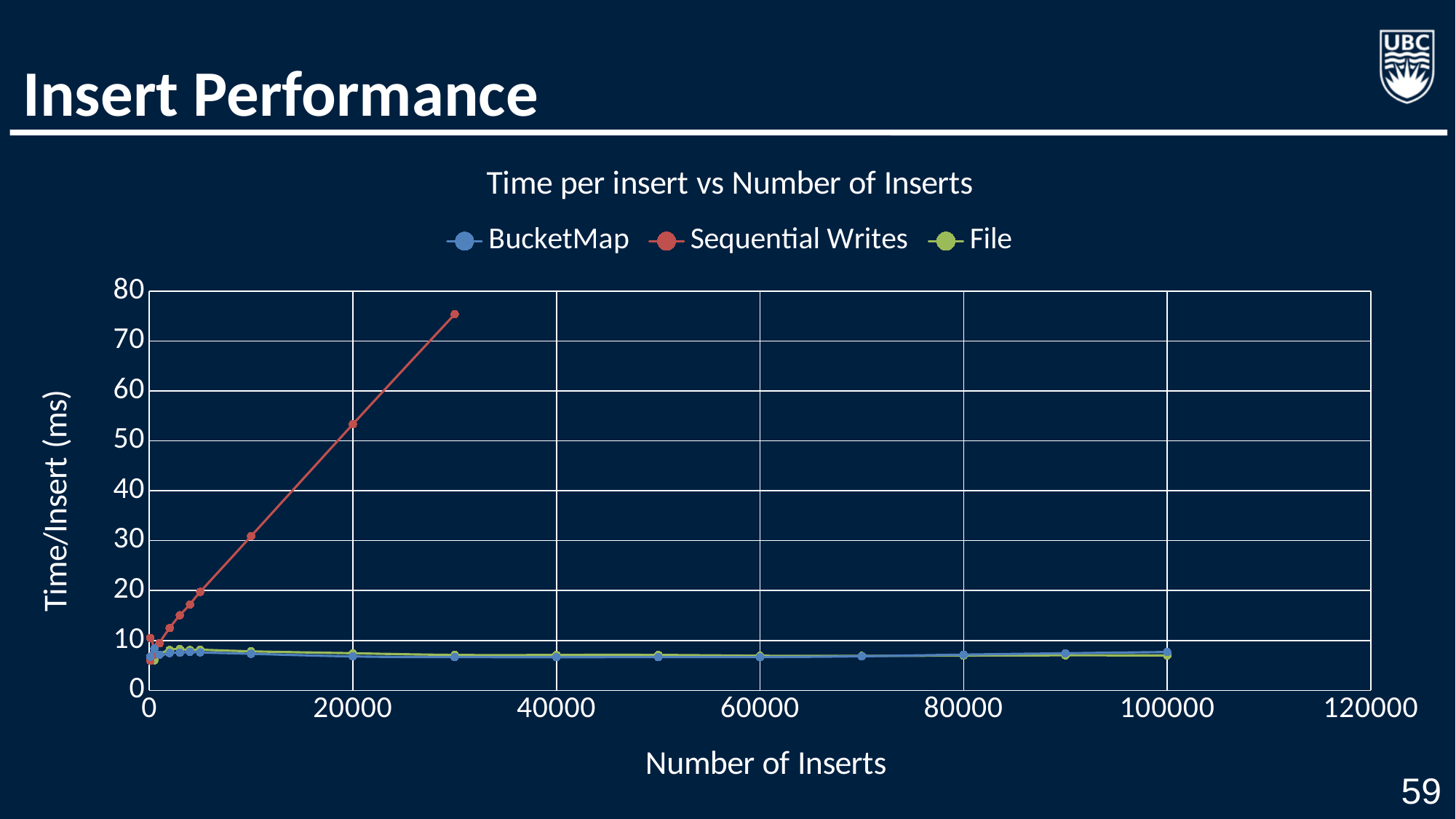
Which series reaches the highest time per insert on the chart? Sequential Writes Is the value for Sequential Writes at 20000 inserts greater or less than 40? greater Is the value for File at 60000 inserts greater or less than 20? less Is the value for BucketMap at 100000 inserts greater or less than 10? less What is the label on the vertical axis of the chart? Time/Insert (ms) How many series does the legend list? 3 Does the Sequential Writes series rise or fall as the number of inserts increases? rise At 10000 inserts, which series has the larger value, File or Sequential Writes? Sequential Writes What is the title of the chart? Time per insert vs Number of Inserts What kind of chart is shown on the slide? line chart At 20000 inserts, which series has the larger value, Sequential Writes or BucketMap? Sequential Writes